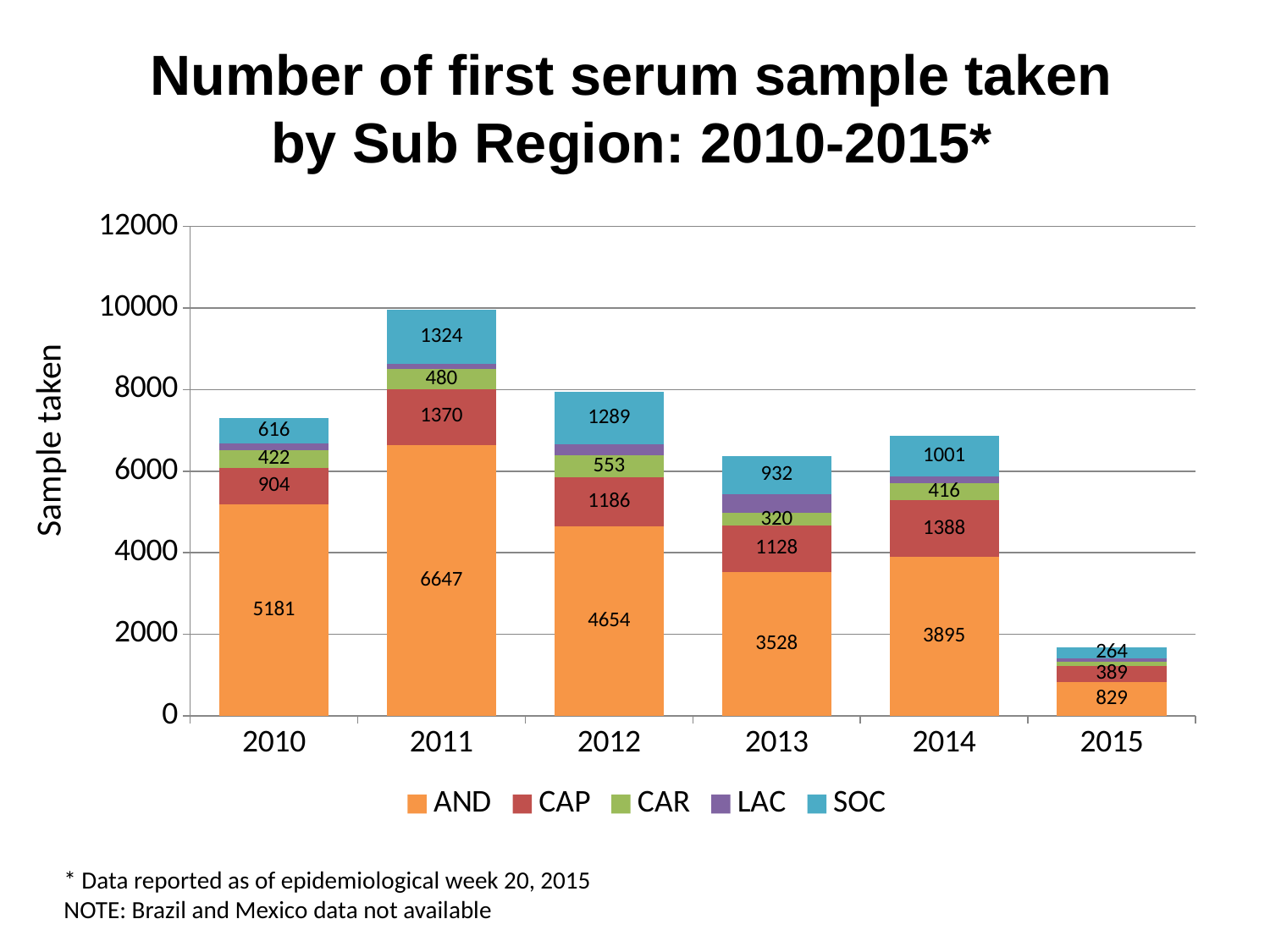
What kind of chart is shown on the slide? Stacked bar chart In which year is the AND value highest? 2011 What is the value for CAR in 2013? 320 Is the total height of the stacked bar for 2013 greater or less than 8000? less How many years are shown on the x axis? 6 What is the value for CAP in 2014? 1388 How many series does the legend list? 5 What is the difference between the AND value in 2010 and the AND value in 2012? 527 Which is larger, the SOC value in 2011 or the SOC value in 2014? 2011 What is the value for SOC in 2012? 1289 In which year is the AND value lowest? 2015 What is the value for AND in 2011? 6647